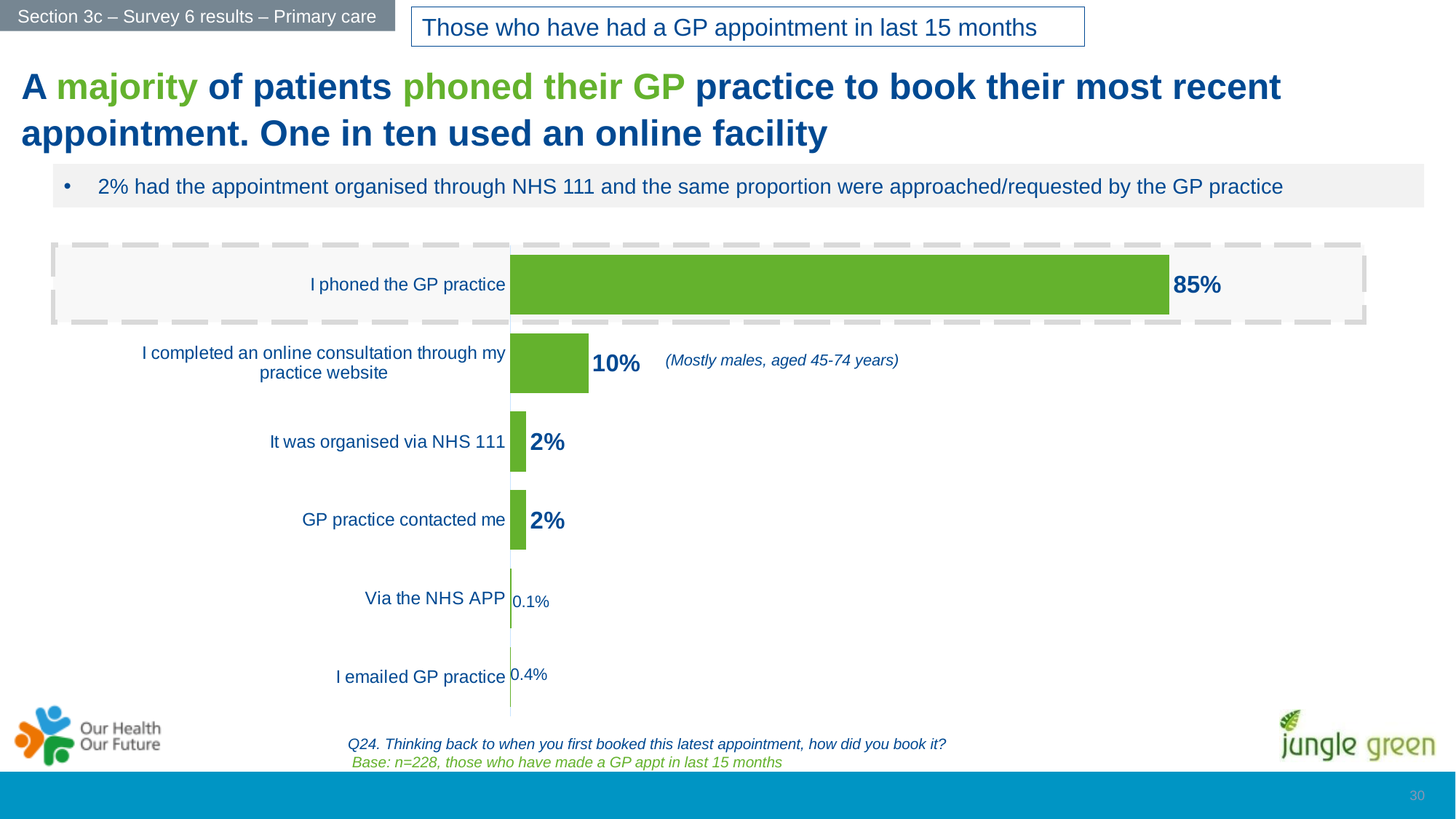
What is the value for 'Via the NHS APP'? 0.1% What percentage completed an online consultation through their practice website? 10% What percentage had their appointment organised via NHS 111? 2% Which booking method has the lowest percentage? Via the NHS APP Which booking method has the highest percentage? I phoned the GP practice How many booking methods are shown in the chart? 6 What percentage of patients phoned the GP practice to book their most recent appointment? 85% What is the difference in percentage points between 'I phoned the GP practice' and 'I completed an online consultation through my practice website'? 75 What annotation is shown next to the 'I completed an online consultation through my practice website' bar? (Mostly males, aged 45-74 years) What type of chart is shown on the slide? Bar chart What is the value for 'I emailed GP practice'? 0.4% Which is larger: the value for 'I emailed GP practice' or the value for 'Via the NHS APP'? I emailed GP practice